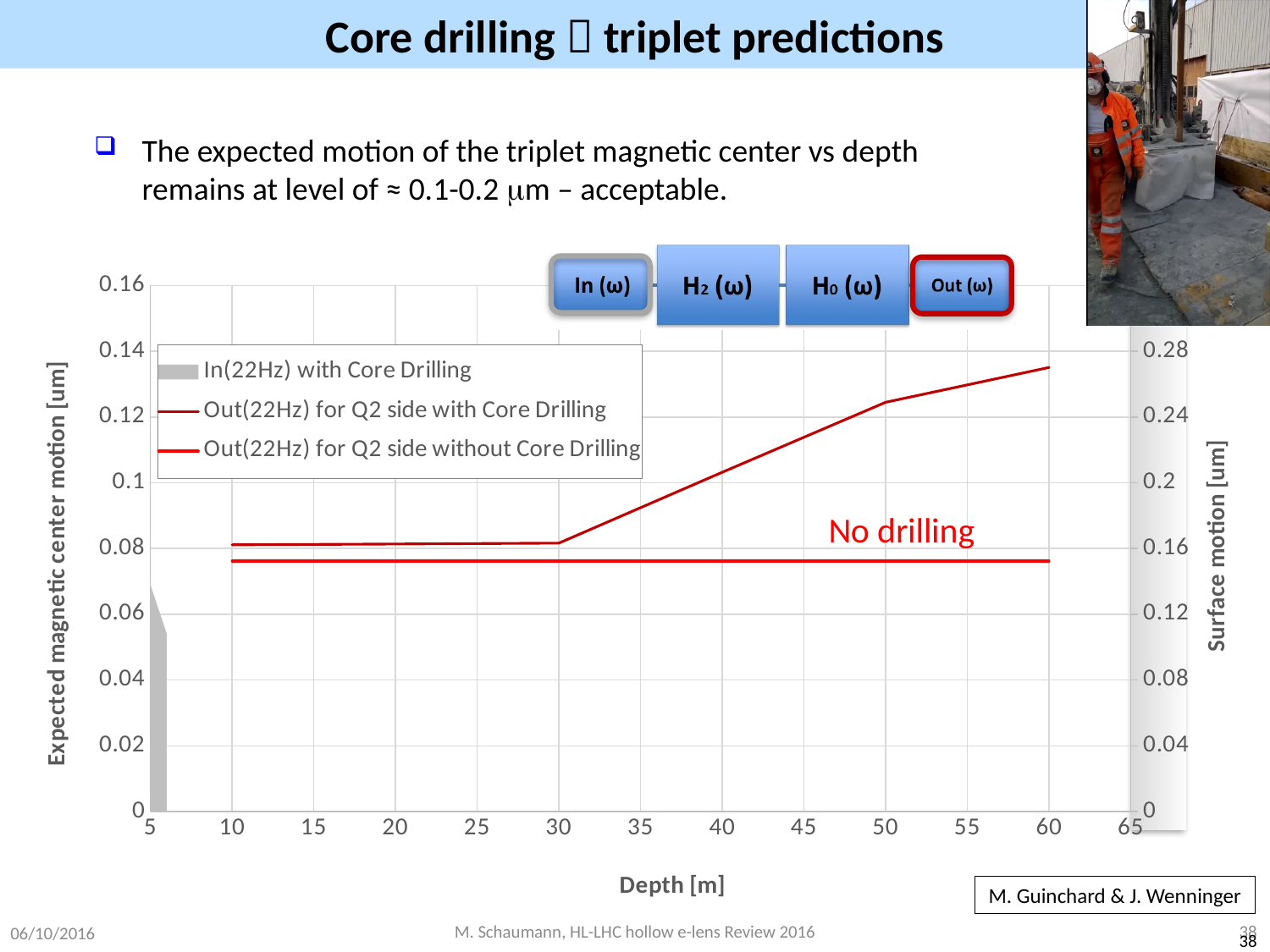
At a depth of 50 m, which series has the larger value: 'Out(22Hz) for Q2 side with Core Drilling' or 'Out(22Hz) for Q2 side without Core Drilling'? Out(22Hz) for Q2 side with Core Drilling What kind of chart is shown on the slide? line chart Is the value of 'Out(22Hz) for Q2 side with Core Drilling' at a depth of 40 m greater or less than 0.08 on the left axis? greater How many series does the chart legend list? 3 Is the value of 'Out(22Hz) for Q2 side with Core Drilling' at a depth of 10 m greater or less than 0.1 on the left axis? less Does the 'Out(22Hz) for Q2 side with Core Drilling' line rise or fall as depth increases from 30 m to 60 m? rise Is the value of 'Out(22Hz) for Q2 side with Core Drilling' at a depth of 60 m greater or less than 0.12 on the left axis? greater Does the 'Out(22Hz) for Q2 side without Core Drilling' line rise, fall, or stay flat as depth increases? stay flat What is the label of the x axis of the chart? Depth [m] What is the label of the left y axis of the chart? Expected magnetic center motion [um]